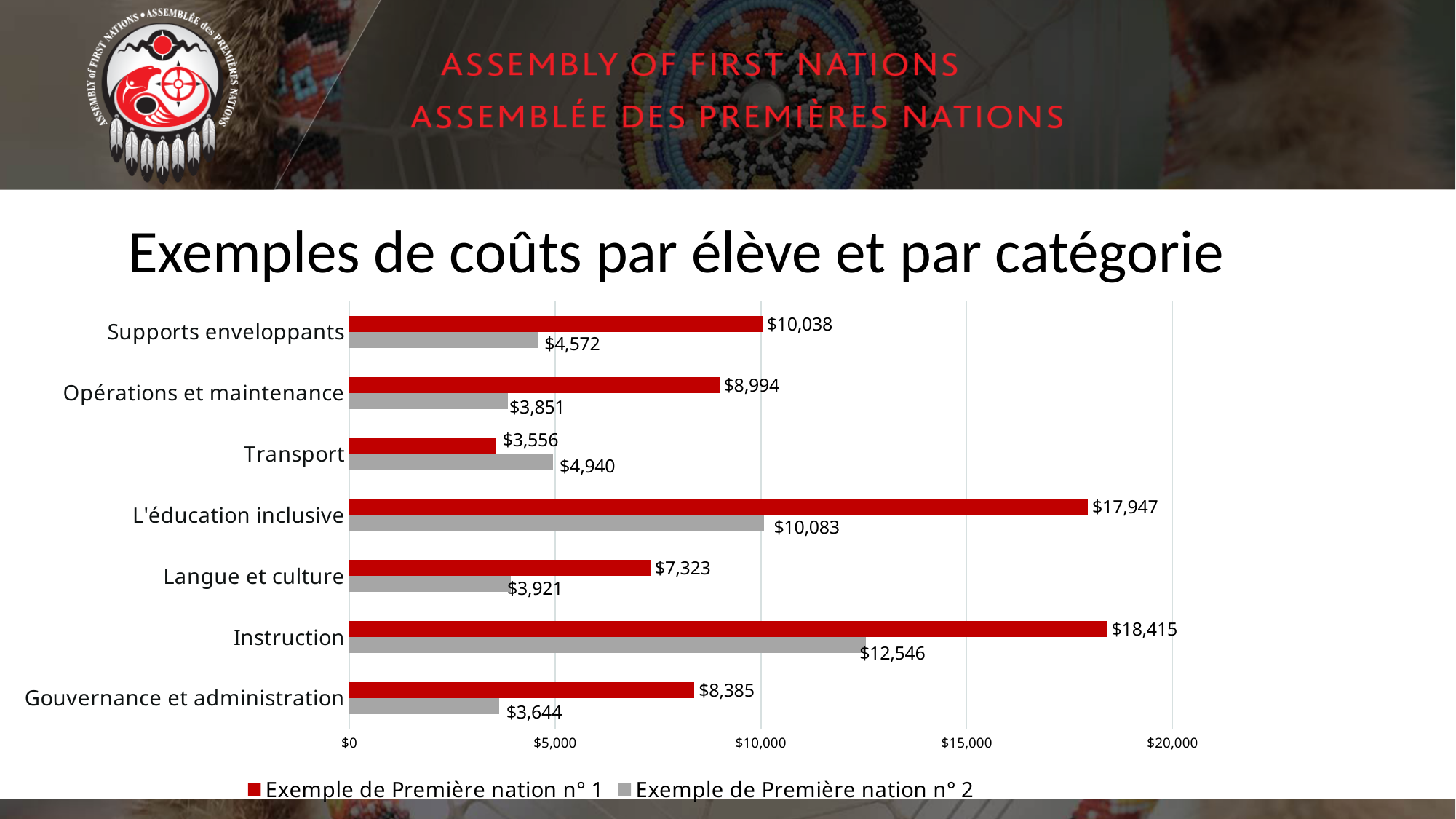
For Transport, which series has the larger value: Exemple de Première nation n° 1 or Exemple de Première nation n° 2? Exemple de Première nation n° 2 What is the difference between Exemple de Première nation n° 1 and Exemple de Première nation n° 2 for Instruction? $5,869 Is the value for L'éducation inclusive for Exemple de Première nation n° 1 greater or less than $15,000? greater What is the title of the chart on the slide? Exemples de coûts par élève et par catégorie Which category has the lowest value for Exemple de Première nation n° 2? Gouvernance et administration How many series does the legend list? 2 Which category has the highest value for Exemple de Première nation n° 1? Instruction What is the value for Transport for Exemple de Première nation n° 2? $4,940 What is the value for Instruction for Exemple de Première nation n° 1? $18,415 How many categories are shown on the chart? 7 What is the value for L'éducation inclusive for Exemple de Première nation n° 2? $10,083 What kind of chart is shown on the slide? bar chart